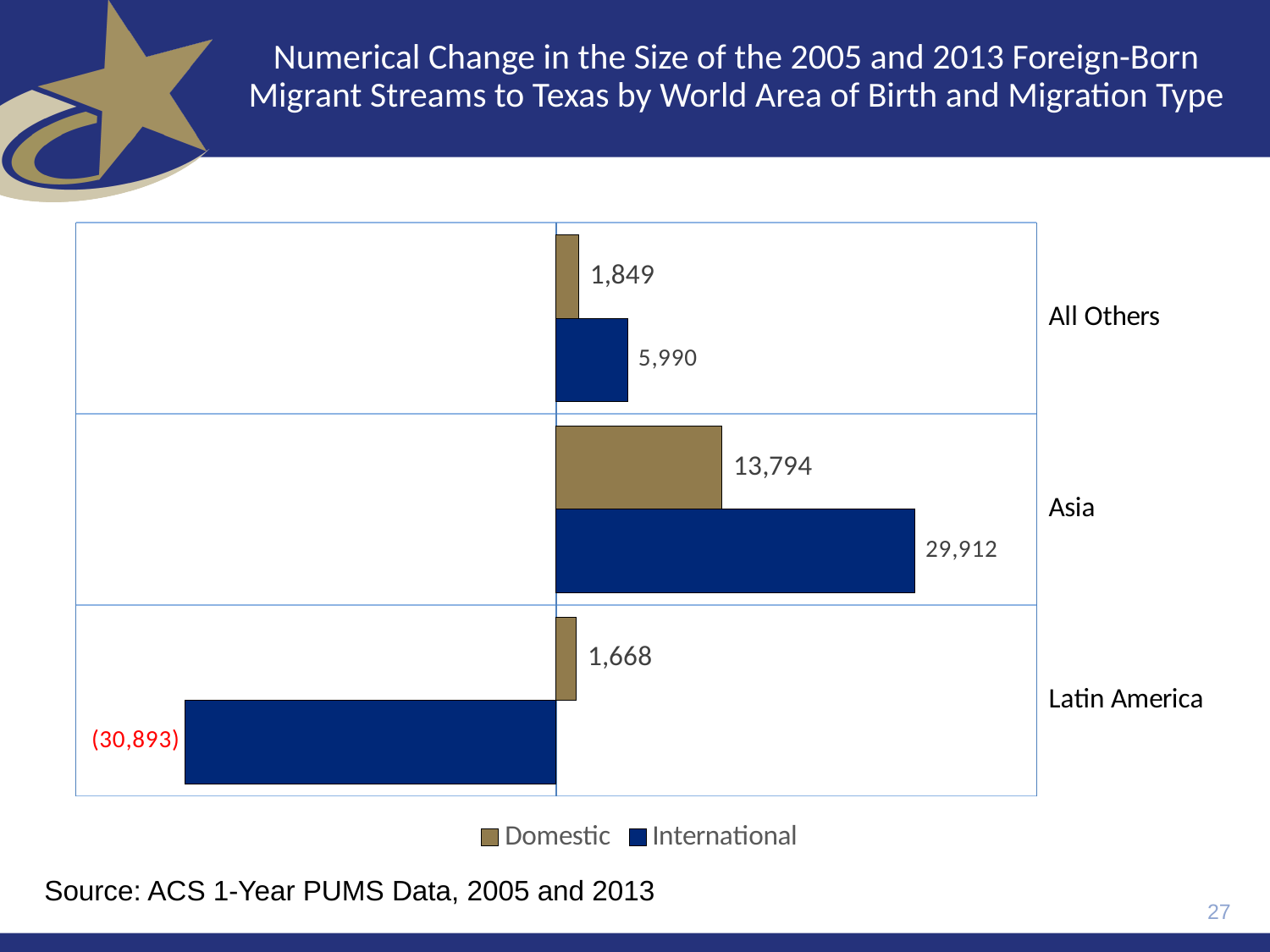
How many series does the legend list? 2 Which world area has the highest International value? Asia What is the International value for All Others? 5,990 How many world areas of birth are shown in the chart? 3 What kind of chart is shown on the slide? Bar chart Which series is shown in dark blue in the legend? International Which is larger for All Others, the Domestic value or the International value? International Which world area has the lowest Domestic value? Latin America What is the International value for Latin America? (30,893) What is the Domestic value for Latin America? 1,668 What is the difference between the International and Domestic values for Asia? 16,118 What is the Domestic value for Asia? 13,794